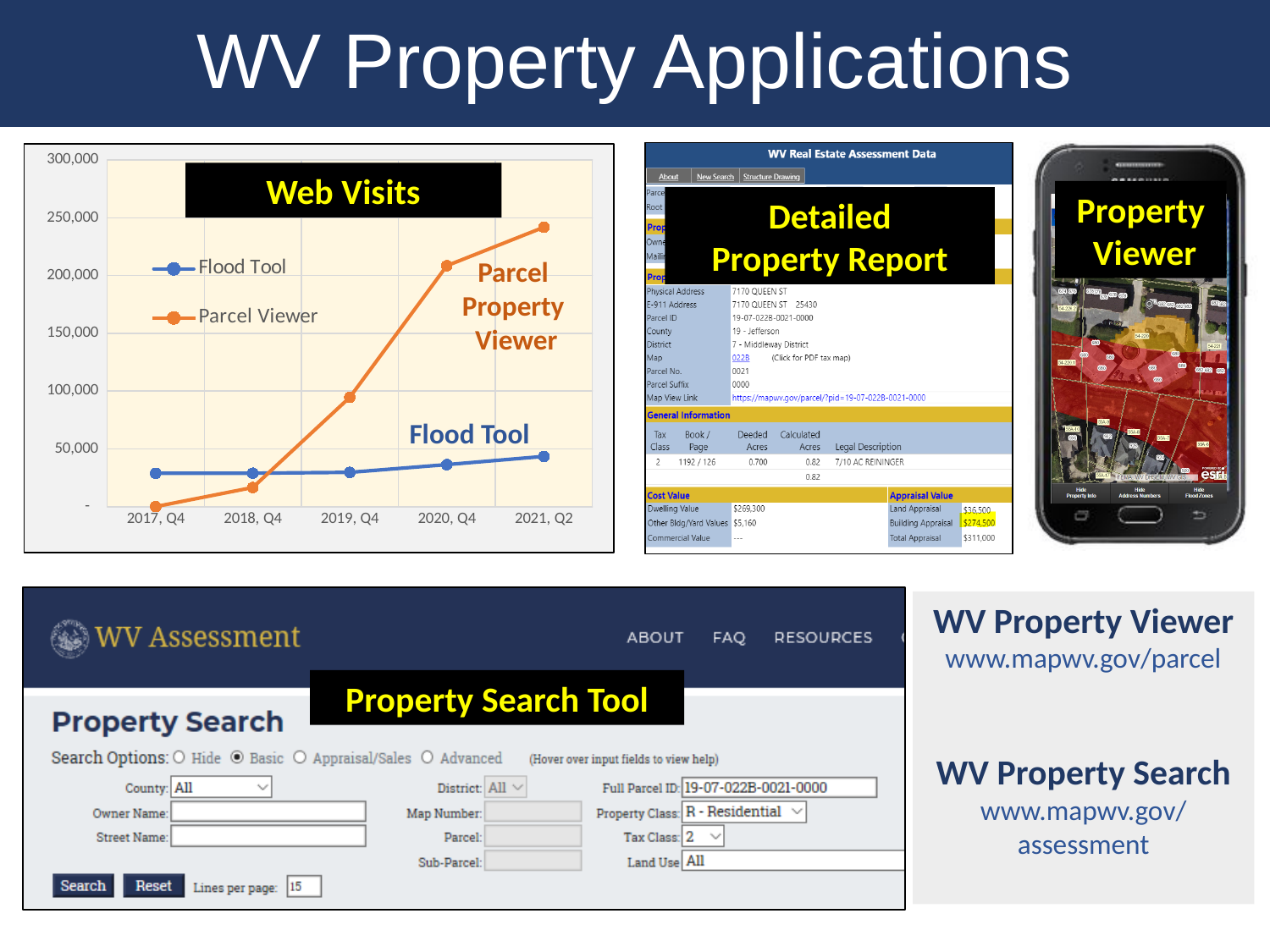
How many series does the legend of the Web Visits chart list? 2 In the Web Visits chart, at which period is the Parcel Viewer value highest? 2021, Q2 In the Web Visits chart, which series has the higher value at 2021, Q2? Parcel Viewer What kind of chart is the Web Visits chart? line chart In the Web Visits chart, at which period is the Parcel Viewer value lowest? 2017, Q4 In the Web Visits chart, do the Parcel Viewer values rise or fall from 2017, Q4 to 2021, Q2? rise In the Web Visits chart, which series has the higher value at 2017, Q4? Flood Tool In the Web Visits chart, is the Parcel Viewer value for 2021, Q2 greater or less than 200,000? greater In the Web Visits chart, is the Parcel Viewer value for 2020, Q4 greater or less than 150,000? greater In the Web Visits chart, is the Flood Tool value for 2017, Q4 greater or less than 50,000? less What colour is the Parcel Viewer line in the Web Visits chart? orange How many time periods are shown on the x axis of the Web Visits chart? 5